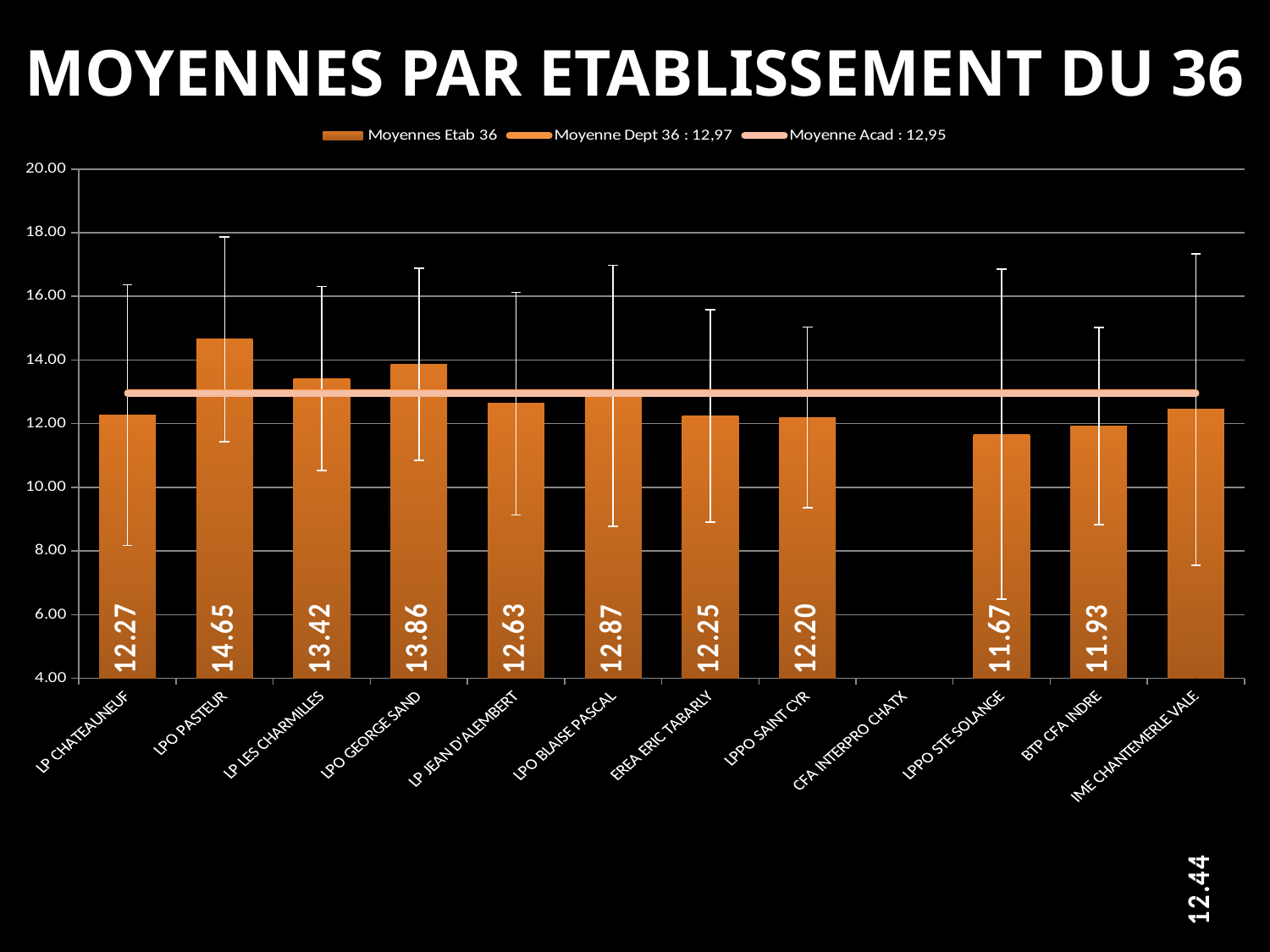
Is the value for LPO PASTEUR greater or less than 14.00? greater How many series does the legend list? 3 Which establishment has the highest average? LPO PASTEUR What is the value for LPPO STE SOLANGE? 11.67 How many establishments are listed on the x axis? 12 What kind of chart is shown on the slide? combination bar and line chart Which establishment with a plotted bar has the lowest average? LPPO STE SOLANGE What is the value for LPO PASTEUR? 14.65 What is the difference between the values for LPO PASTEUR and LPPO STE SOLANGE? 2.98 Which is larger, the value for LP CHATEAUNEUF or the value for BTP CFA INDRE? LP CHATEAUNEUF What is the difference between the values for LPO GEORGE SAND and LP LES CHARMILLES? 0.44 What is the value for LP JEAN D'ALEMBERT? 12.63